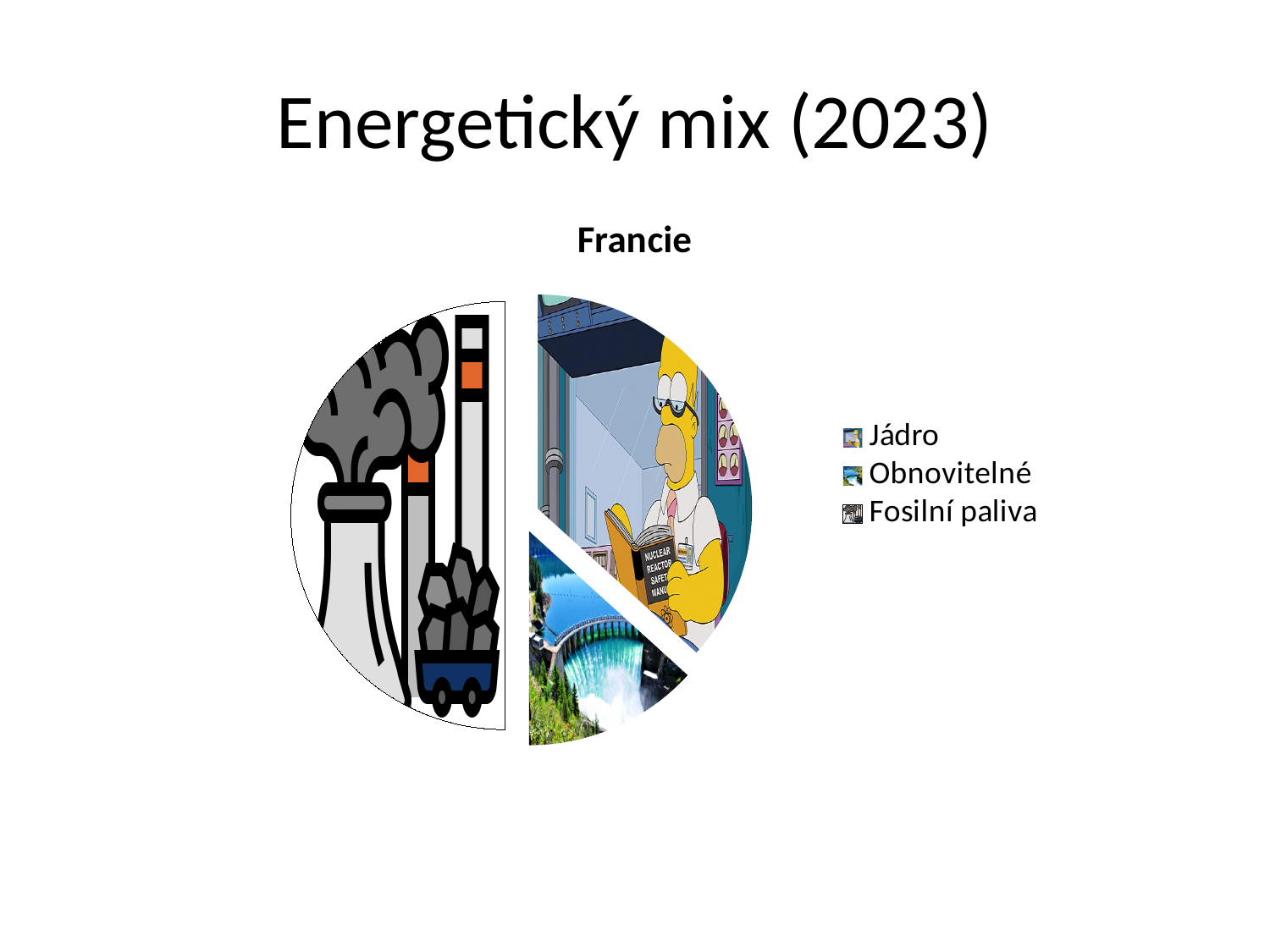
Which category has the smallest slice in the pie chart? Obnovitelné What is the title of the pie chart? Francie How many slices does the pie chart have? 3 Which category has the largest slice in the pie chart? Fosilní paliva What are the legend entries of the pie chart? Jádro, Obnovitelné, Fosilní paliva Which slice is larger, Jádro or Obnovitelné? Jádro What kind of chart is shown on the slide? pie chart Which slice is larger, Fosilní paliva or Obnovitelné? Fosilní paliva How many entries does the legend of the pie chart list? 3